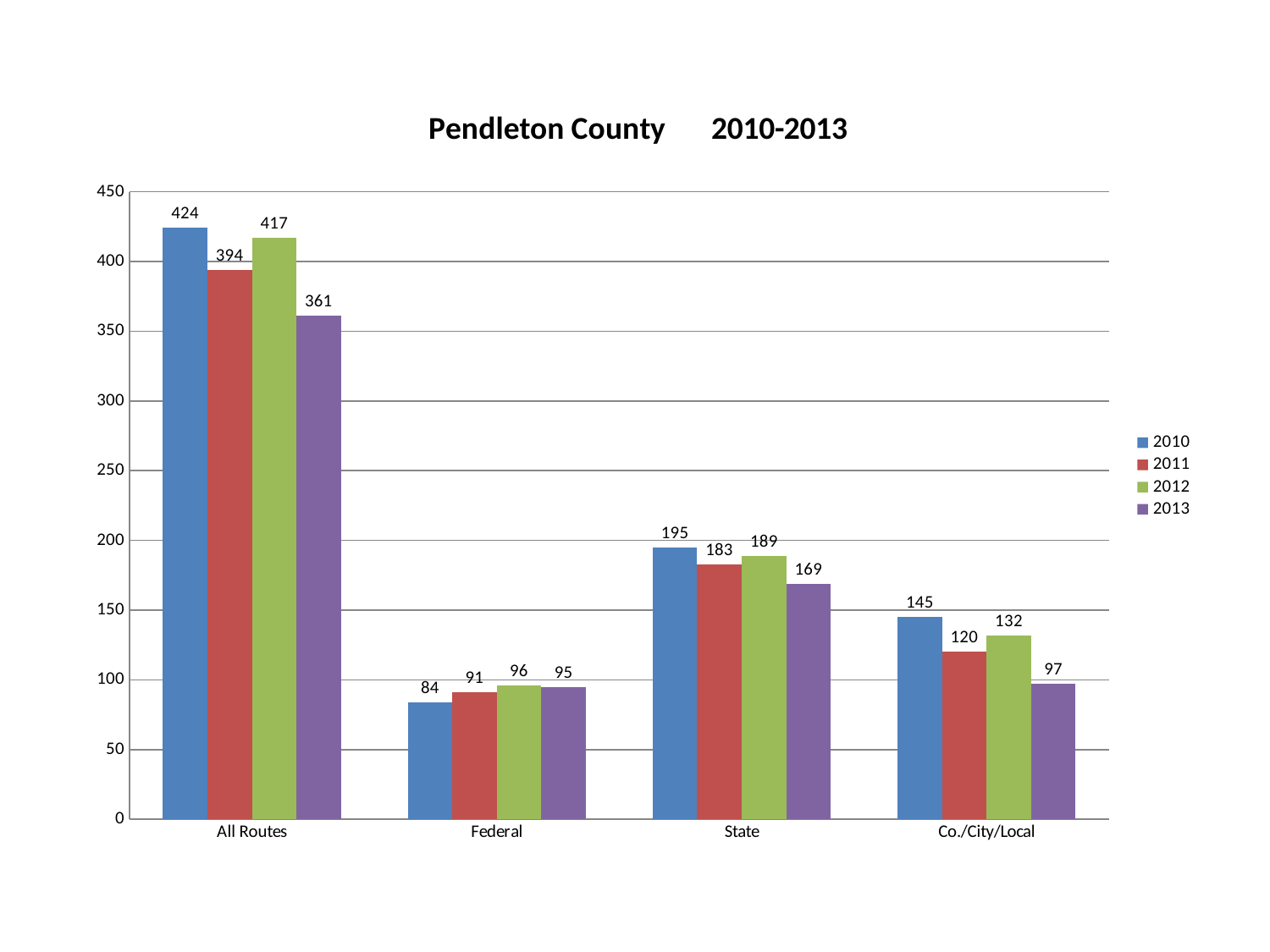
What is the value for All Routes in 2010? 424 How many series does the legend list? 4 Which year has the lowest value for Federal? 2010 What is the title of the chart? Pendleton County 2010-2013 What kind of chart is this? bar chart Which year has the highest value for All Routes? 2010 What is the difference between the 2010 and 2013 values for State? 26 What is the value for Co./City/Local in 2013? 97 Which is larger, the 2011 value for Co./City/Local or the 2012 value for Co./City/Local? 2012 How many categories are shown on the x axis? 4 What is the value for State in 2011? 183 What is the value for Federal in 2012? 96